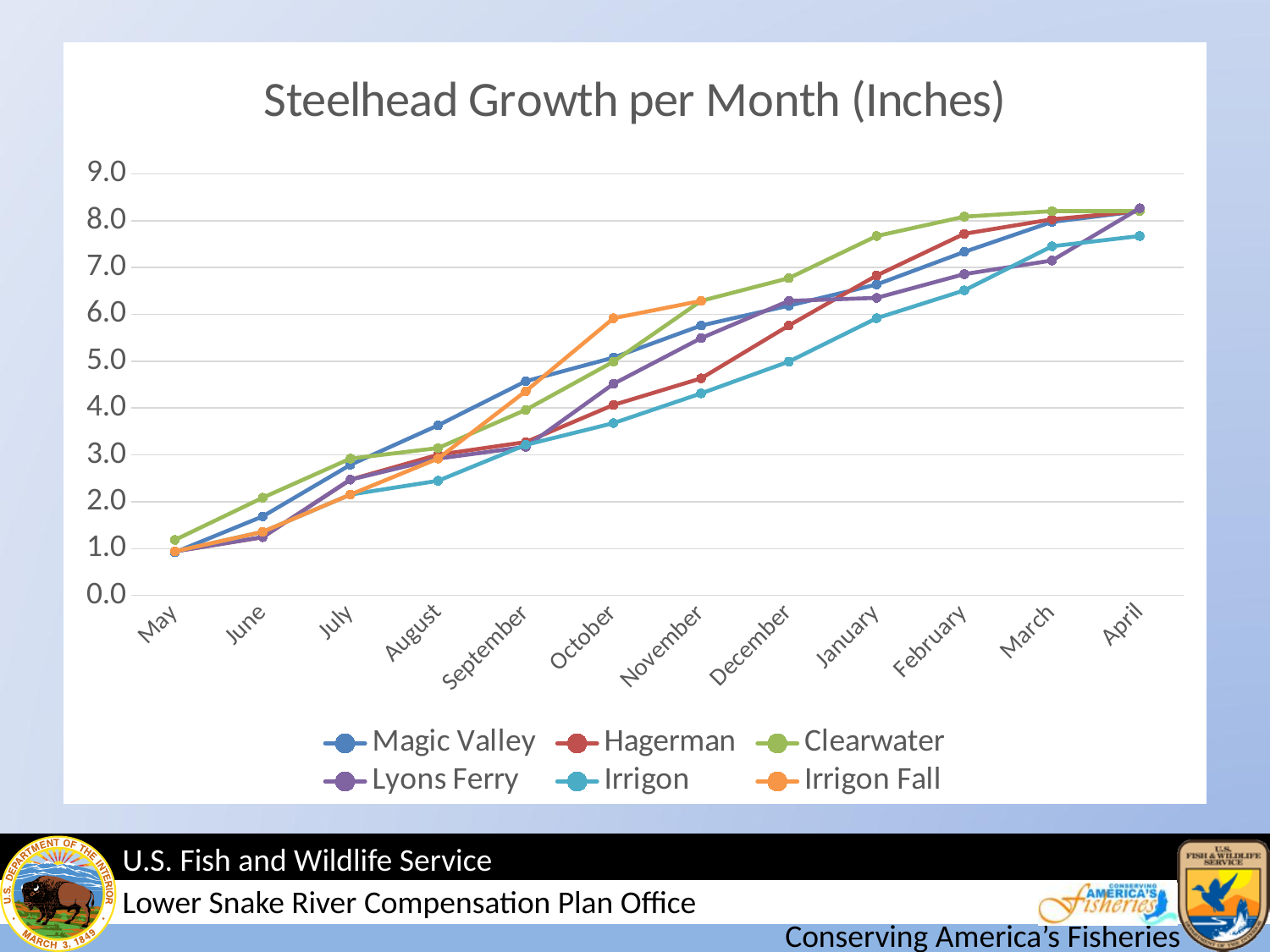
In November, which is higher: Clearwater or Hagerman? Clearwater Is the value for Irrigon in December greater or less than 6.0? less Does the Magic Valley line rise or fall from May to April? rise How many months are shown along the x axis? 12 Which series has the highest value in October? Irrigon Fall Which series has the lowest value in April? Irrigon In February, which is higher: Clearwater or Irrigon? Clearwater How many series does the legend list? 6 Which series stops at November instead of continuing to April? Irrigon Fall What kind of chart is shown on the slide? line chart Is the value for Clearwater in January greater or less than 7.0? greater Is the value for Magic Valley in September greater or less than 4.0? greater